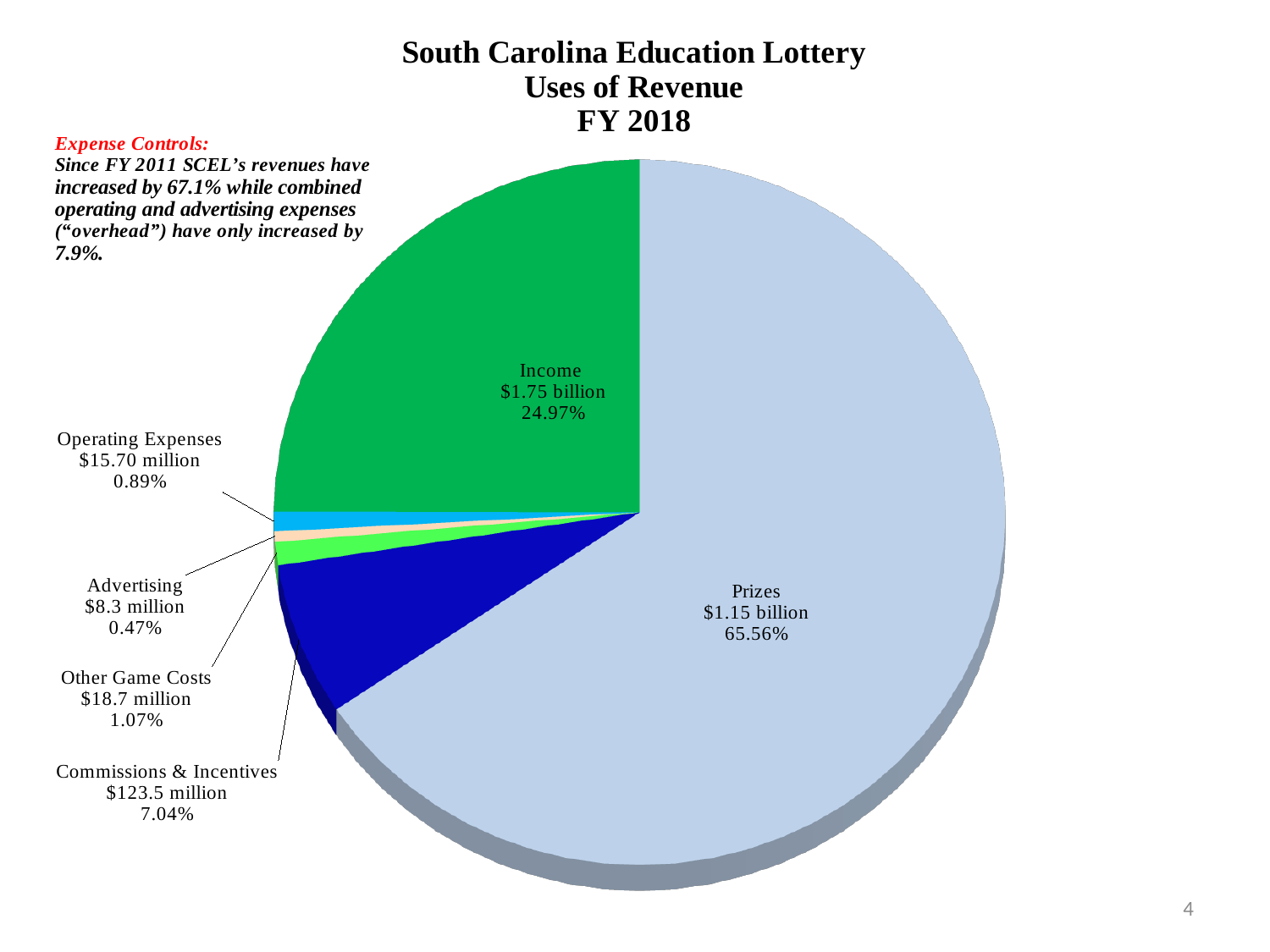
How many slices does the pie chart have? 6 What is the dollar value shown for Commissions & Incentives? $123.5 million Which is larger, the share for Other Game Costs or the share for Operating Expenses? Other Game Costs What is the dollar value shown for Prizes? $1.15 billion What kind of chart is shown on the slide? Pie chart What share of the pie does Prizes represent? 65.56% Which category has the smallest slice of the pie? Advertising What is the dollar value shown for Operating Expenses? $15.70 million Which category has the largest slice of the pie? Prizes What percentage is shown for Other Game Costs? 1.07% What is the dollar value shown for Advertising? $8.3 million What percentage is shown for Income? 24.97%